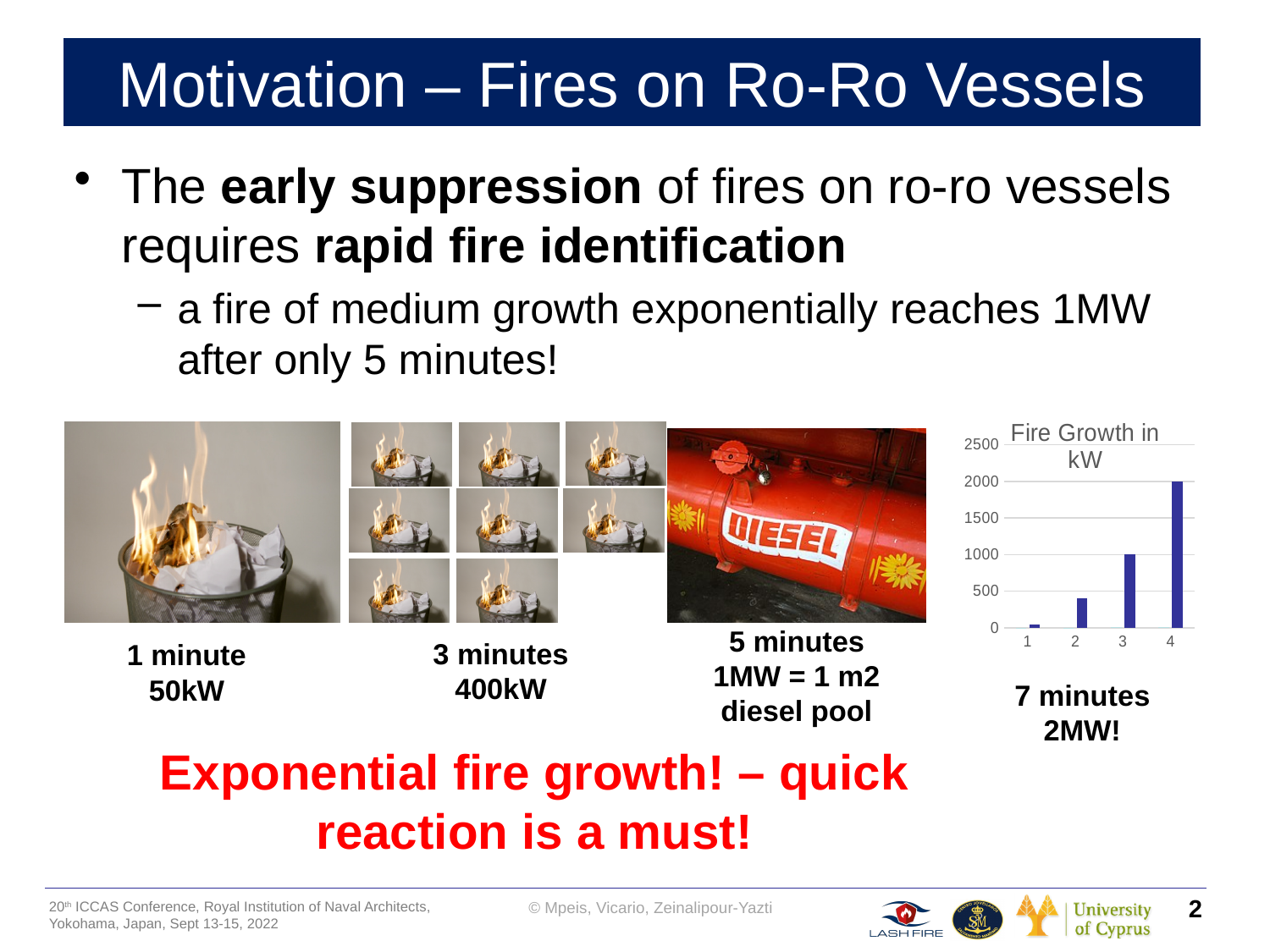
What is the value for category 3 in the Fire Growth in kW chart? 1000 How many bars does the Fire Growth in kW chart have? 4 In the Fire Growth in kW chart, is the value for category 2 greater or less than 500? less What is the title of the chart on the slide? Fire Growth in kW In the Fire Growth in kW chart, is the value for category 3 greater or less than 500? greater What kind of chart is shown on the slide? bar chart In the Fire Growth in kW chart, is the value for category 4 greater or less than 1500? greater What is the value for category 4 in the Fire Growth in kW chart? 2000 Which category has the lowest value in the Fire Growth in kW chart? 1 In the Fire Growth in kW chart, which is larger, the value for category 2 or the value for category 4? 4 Which category has the highest value in the Fire Growth in kW chart? 4 Do the values in the Fire Growth in kW chart rise or fall from category 1 to category 4? rise